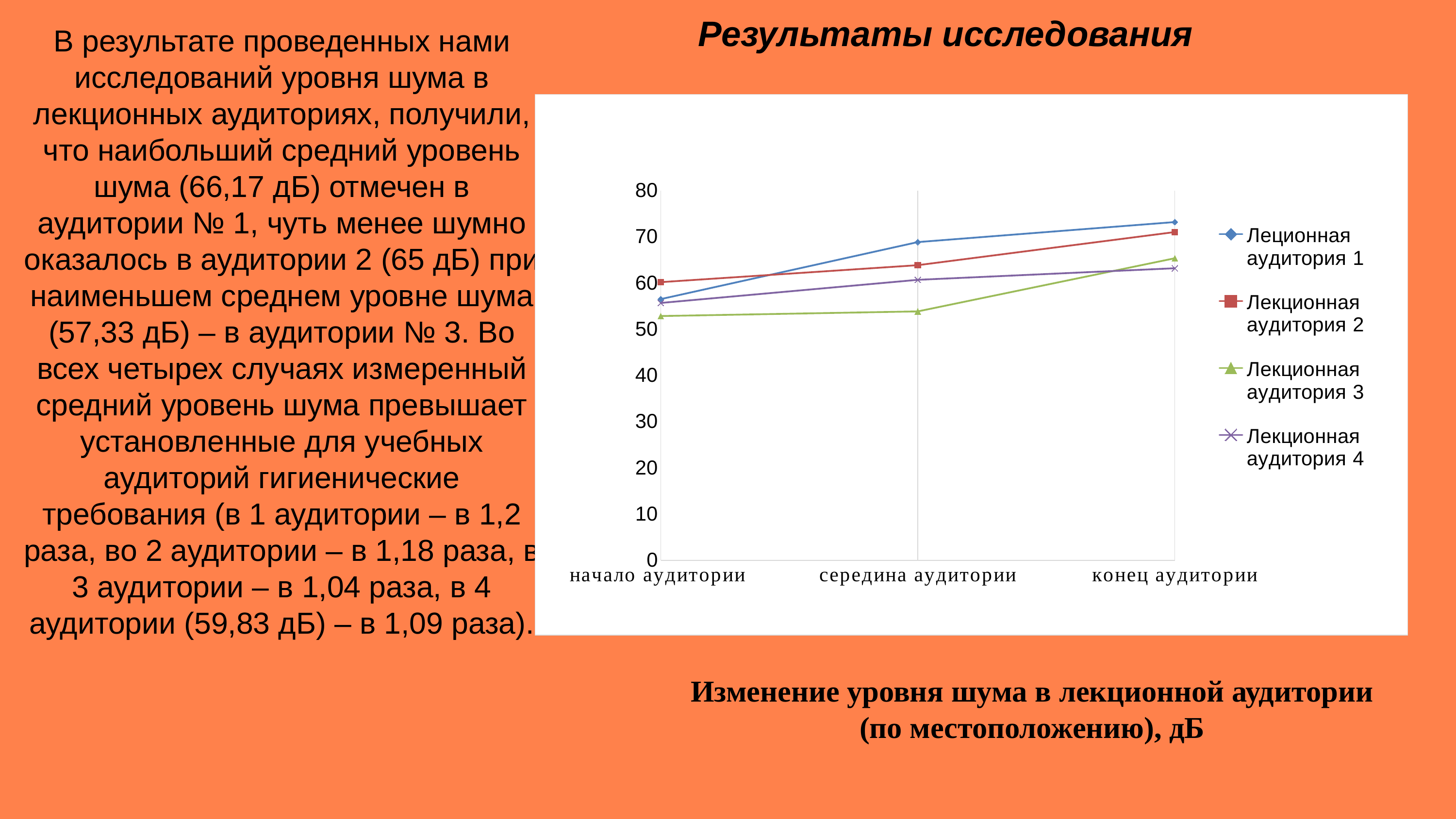
Is the value for Лекционная аудитория 4 at конец аудитории greater or less than 70? less How many series does the legend list? 4 Is the value for Лекционная аудитория 3 at середина аудитории greater or less than 60? less What kind of chart is shown on the slide? line chart What is the caption below the chart? Изменение уровня шума в лекционной аудитории (по местоположению), дБ Is the value for Лекционная аудитория 3 at начало аудитории greater or less than 60? less Which series has the highest value at начало аудитории? Лекционная аудитория 2 Which series has the lowest value at середина аудитории? Лекционная аудитория 3 How many categories are shown on the x axis? 3 Do the values for Леционная аудитория 1 rise or fall from начало аудитории to конец аудитории? rise